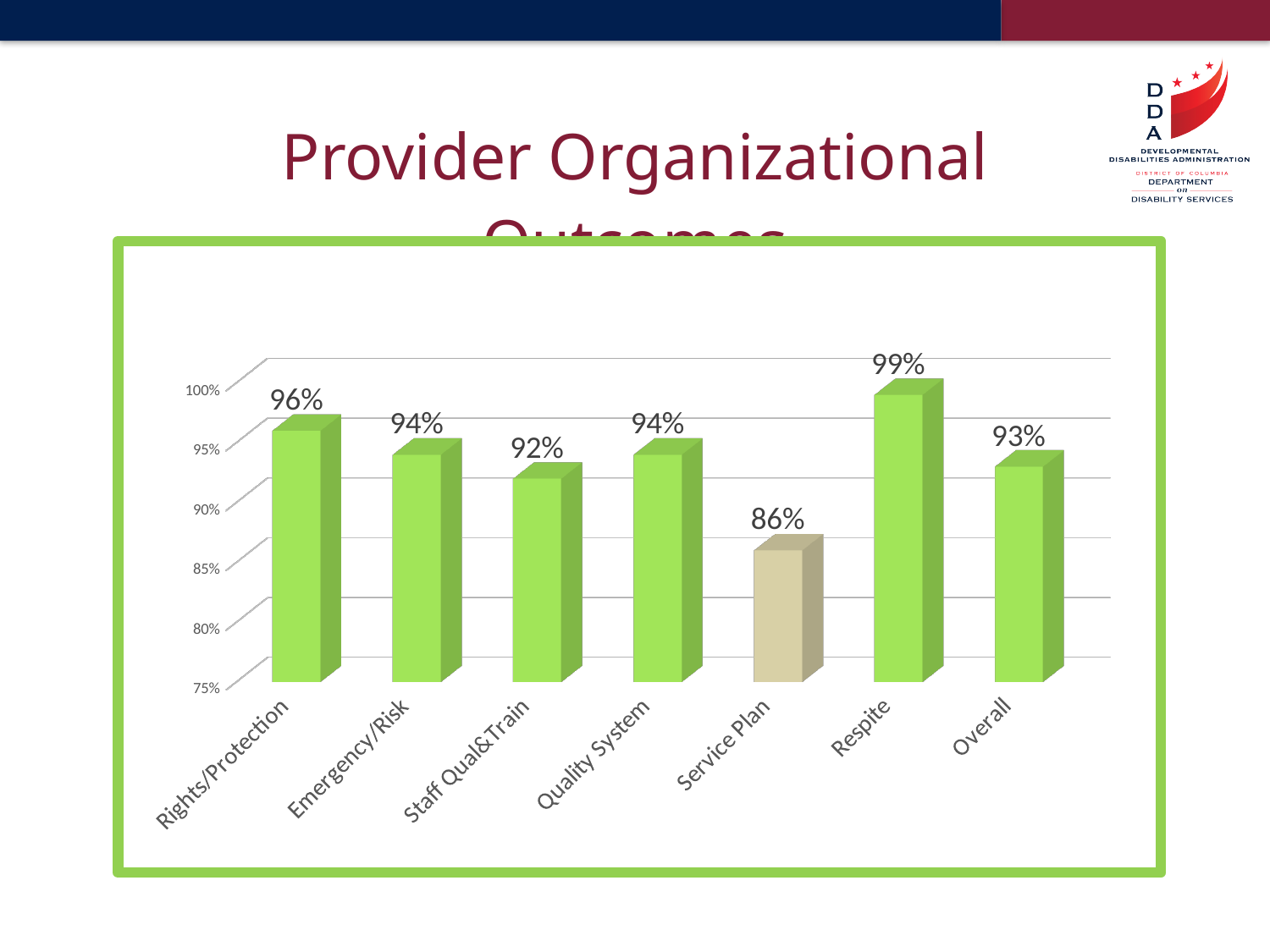
How many categories are shown on the x axis? 7 Which is larger, the value for Rights/Protection or the value for Staff Qual&Train? Rights/Protection Which bar is shown in a different colour from the others? Service Plan What is the value for Respite? 99% What is the value for Service Plan? 86% What is the value for Overall? 93% Which category has the highest value? Respite What is the value for Rights/Protection? 96% Which category has the lowest value? Service Plan Is the value for Service Plan greater or less than 90%? less What kind of chart is shown on the slide? bar chart What is the difference between the values for Respite and Service Plan? 13%